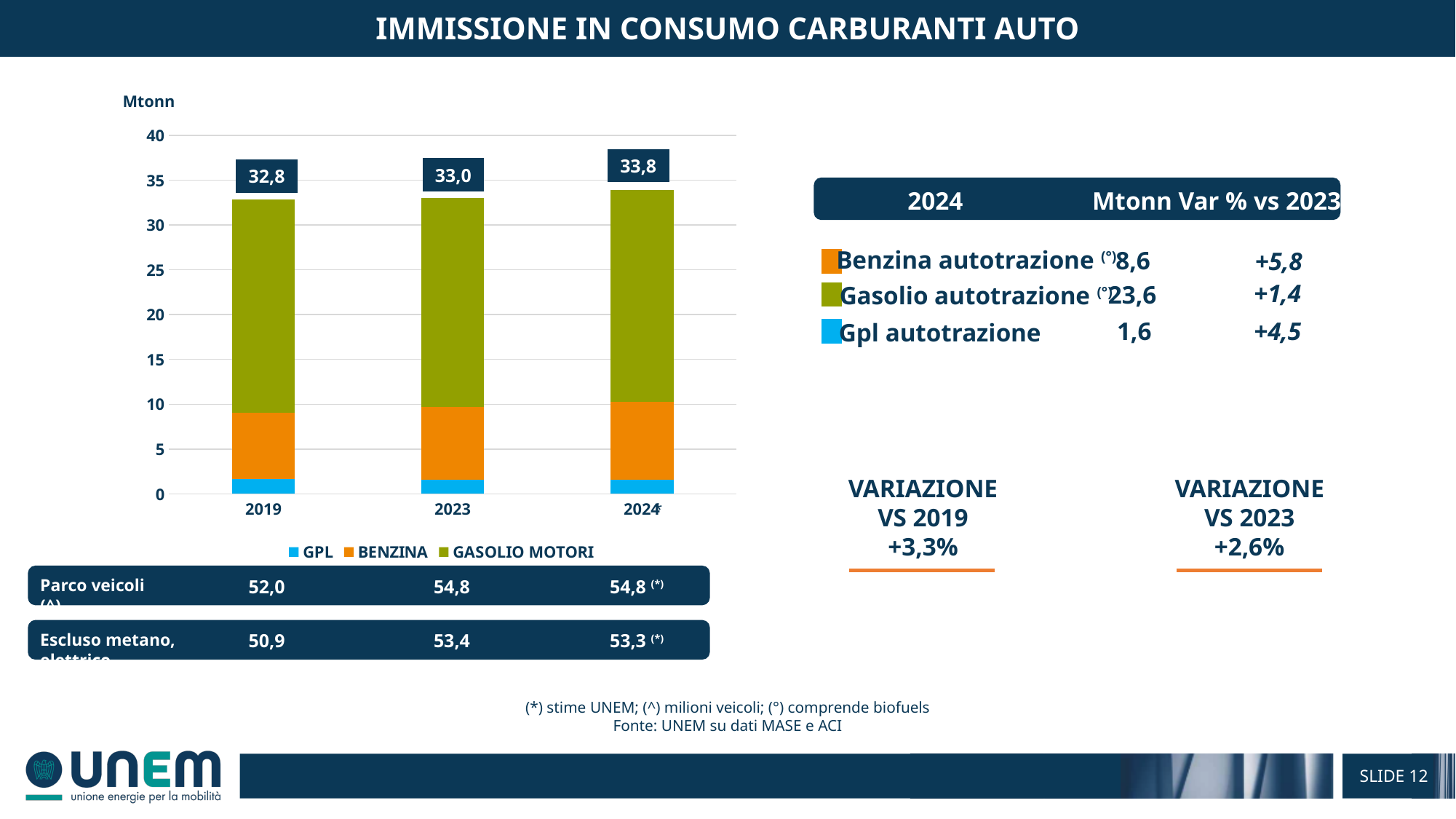
What is the difference between the 2024 total and the 2019 total? 1,0 What is the total value shown on top of the 2023 bar? 33,0 Which year has the highest total in the chart? 2024 Which bar has the larger total, 2023 or 2024? 2024 Is the GASOLIO MOTORI segment of the 2019 bar greater or less than 20? greater Do the bar totals rise or fall from 2019 to 2024? Rise How many series does the chart legend list? 3 Which year has the lowest total in the chart? 2019 What is the total value shown on top of the 2024 bar? 33,8 What type of chart is shown on the slide? Stacked bar chart How many bars (years) are shown in the chart? 3 What is the total value shown on top of the 2019 bar? 32,8